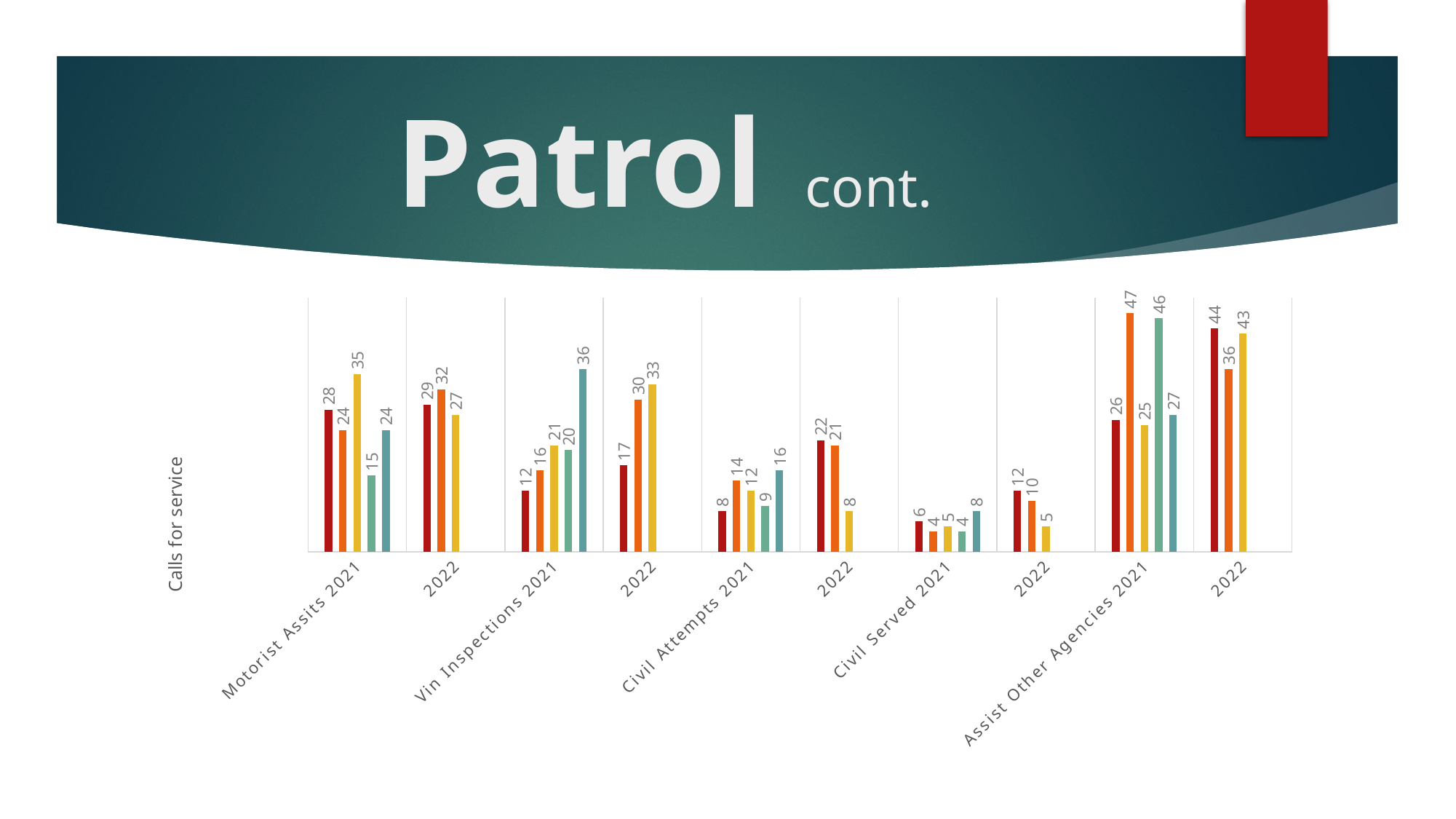
What is the lowest value labelled on the chart? 4 Which category group contains the bar with the highest value on the chart? Assist Other Agencies 2021 How many category groups are shown along the x axis of the chart? 10 What is the label on the vertical axis of the chart? Calls for service Which is larger: the first bar in the Motorist Assists 2021 group or the first bar in the Motorist Assists 2022 group? Motorist Assists 2022 (29) How many bars are shown in the Motorist Assists 2021 group? 5 What is the total of the five bars in the Civil Served 2021 group? 27 What is the value of the first (dark red) bar in the Civil Served 2022 group? 12 What is the value of the last (teal) bar in the Vin Inspections 2021 group? 36 What is the highest value labelled anywhere on the chart? 47 In the Assist Other Agencies 2021 group, what is the difference between the highest bar (47) and the lowest bar (25)? 22 What kind of chart is shown on the slide? bar chart